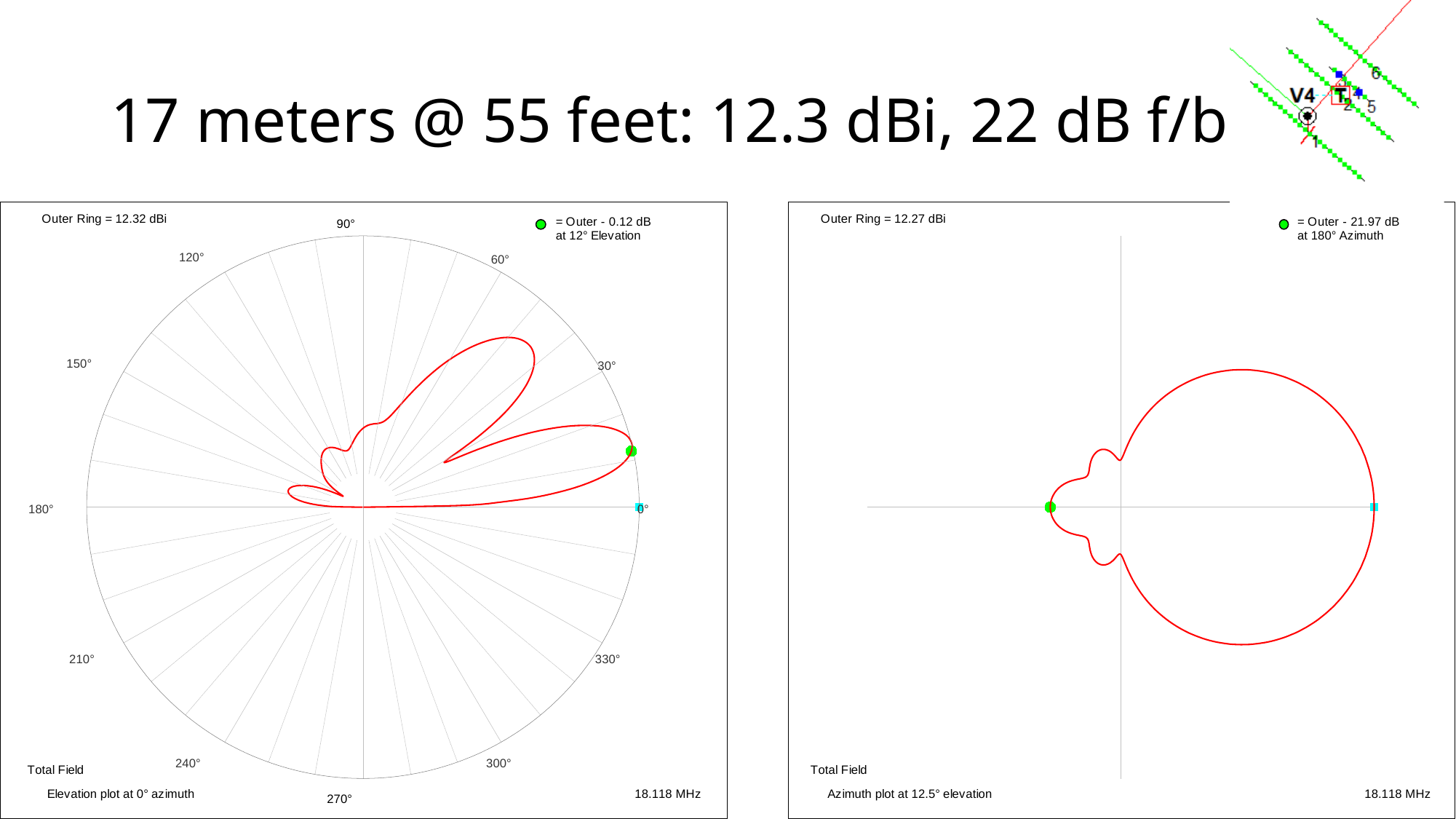
On the left chart (Elevation plot at 0° azimuth), how far below the outer ring is the green marker? 0.12 dB Which chart has the larger outer ring value, the left elevation plot or the right azimuth plot? the left elevation plot On the left chart (Elevation plot at 0° azimuth), at what elevation angle is the green marker placed? 12° Elevation What field type is labelled at the bottom left of the right chart (Azimuth plot at 12.5° elevation)? Total Field What is the title of the slide? 17 meters @ 55 feet: 12.3 dBi, 22 dB f/b What is the outer ring value on the left chart (Elevation plot at 0° azimuth)? 12.32 dBi What frequency is shown on the left chart (Elevation plot at 0° azimuth)? 18.118 MHz On the right chart (Azimuth plot at 12.5° elevation), at what azimuth is the green marker placed? 180° Azimuth What is the difference between the outer ring values of the left chart (12.32 dBi) and the right chart (12.27 dBi)? 0.05 dBi On the right chart (Azimuth plot at 12.5° elevation), how far below the outer ring is the green marker? 21.97 dB What kind of chart is the left chart (Elevation plot at 0° azimuth)? polar chart What is the outer ring value on the right chart (Azimuth plot at 12.5° elevation)? 12.27 dBi